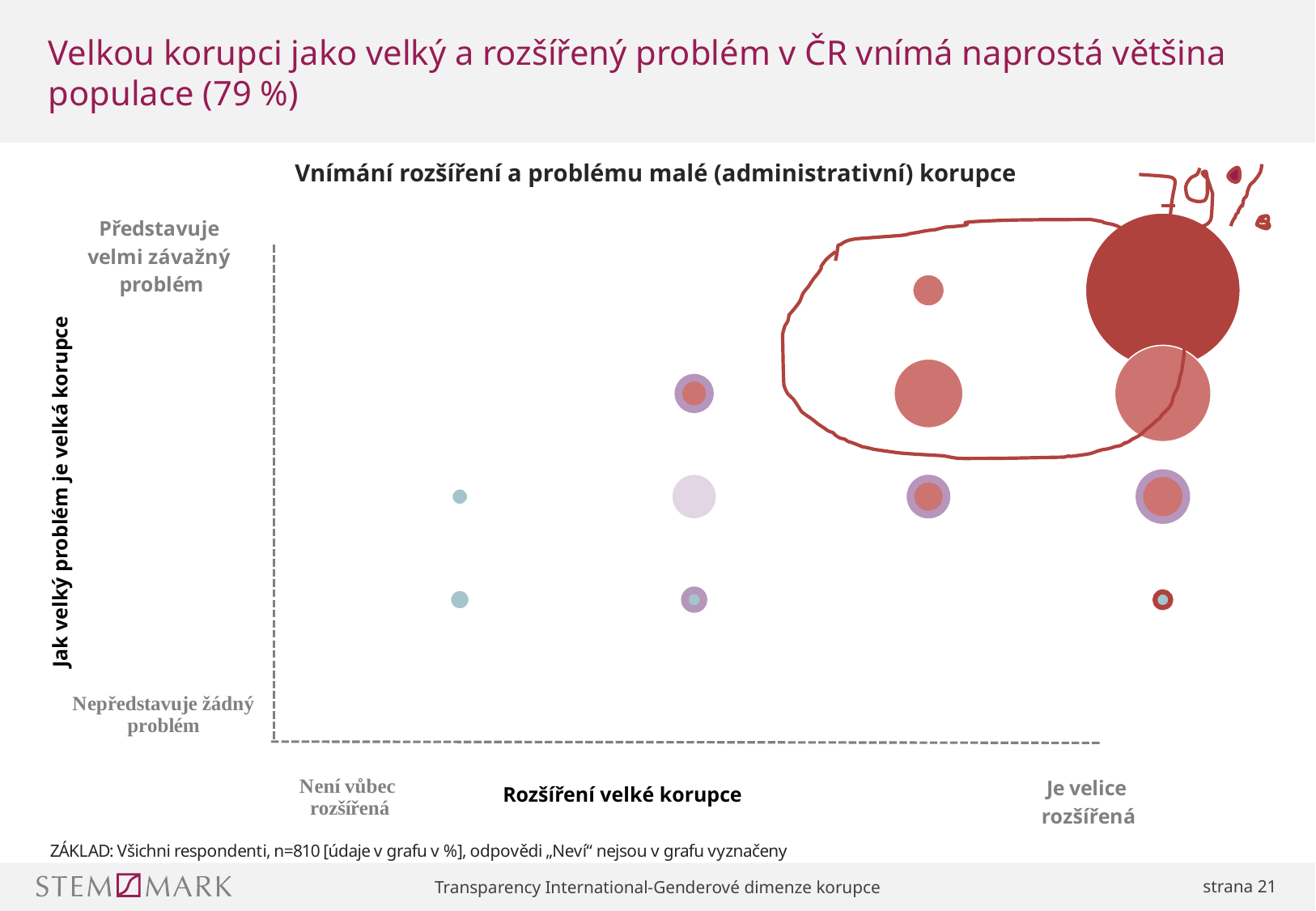
Do the bubbles generally get larger or smaller as you move from left to right along the x axis? larger What is the label of the horizontal axis of the chart? Rozšíření velké korupce What is the title of the chart? Vnímání rozšíření a problému malé (administrativní) korupce Is the largest bubble in the chart located near the 'Je velice rozšířená' end or the 'Není vůbec rozšířená' end of the x axis? Je velice rozšířená What percentage is written next to the circled group of bubbles in the top right of the chart? 79 % Is the largest bubble in the chart located near the 'Představuje velmi závažný problém' end or the 'Nepředstavuje žádný problém' end of the y axis? Představuje velmi závažný problém Which position on the chart has the largest bubble? top right (Je velice rozšířená / Představuje velmi závažný problém) What kind of chart is shown on the slide? bubble chart How many columns of bubbles are plotted along the x axis of the chart? 4